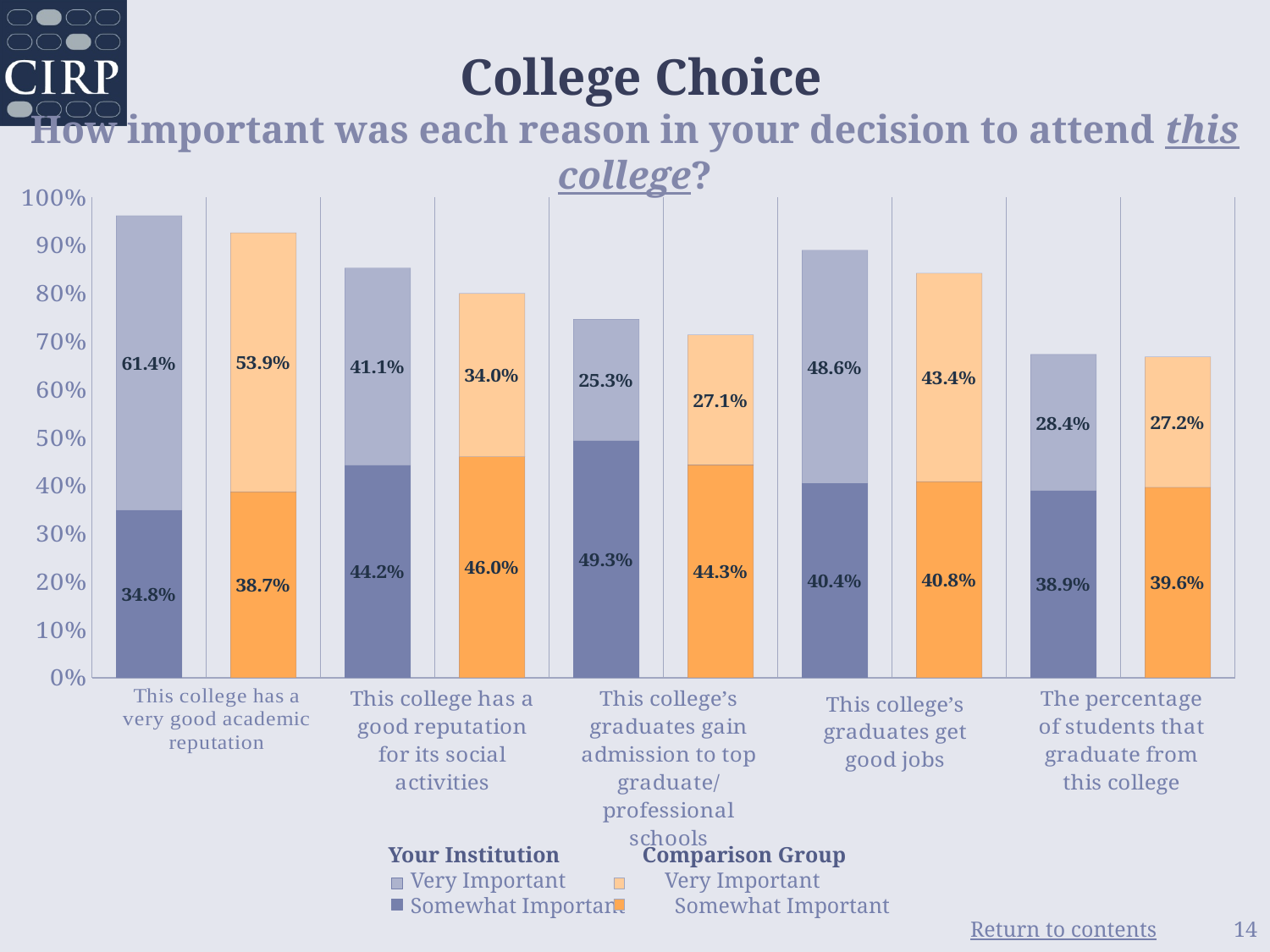
For "This college has a good reputation for its social activities", which is larger: the Your Institution Very Important percentage or the Comparison Group Very Important percentage? Your Institution (41.1%) What percentage of the Comparison Group rated "This college's graduates get good jobs" as Somewhat Important? 40.8% How many series does the chart legend list? 4 Which reason has the highest Very Important percentage for Your Institution? This college has a very good academic reputation How many reasons (categories) are shown on the x axis of the chart? 5 What percentage of Your Institution students rated "This college has a very good academic reputation" as Very Important? 61.4% What is the total (Very Important plus Somewhat Important) for the Comparison Group on "This college has a good reputation for its social activities"? 80.0% What type of chart is shown on the slide? Stacked bar chart What percentage of Your Institution students rated "The percentage of students that graduate from this college" as Very Important? 28.4% Which reason has the lowest Very Important percentage for the Comparison Group? This college's graduates gain admission to top graduate/professional schools What is the difference between the Your Institution and Comparison Group Very Important percentages for "This college has a very good academic reputation"? 7.5% What is the total (Very Important plus Somewhat Important) for Your Institution on "This college's graduates get good jobs"? 89.0%